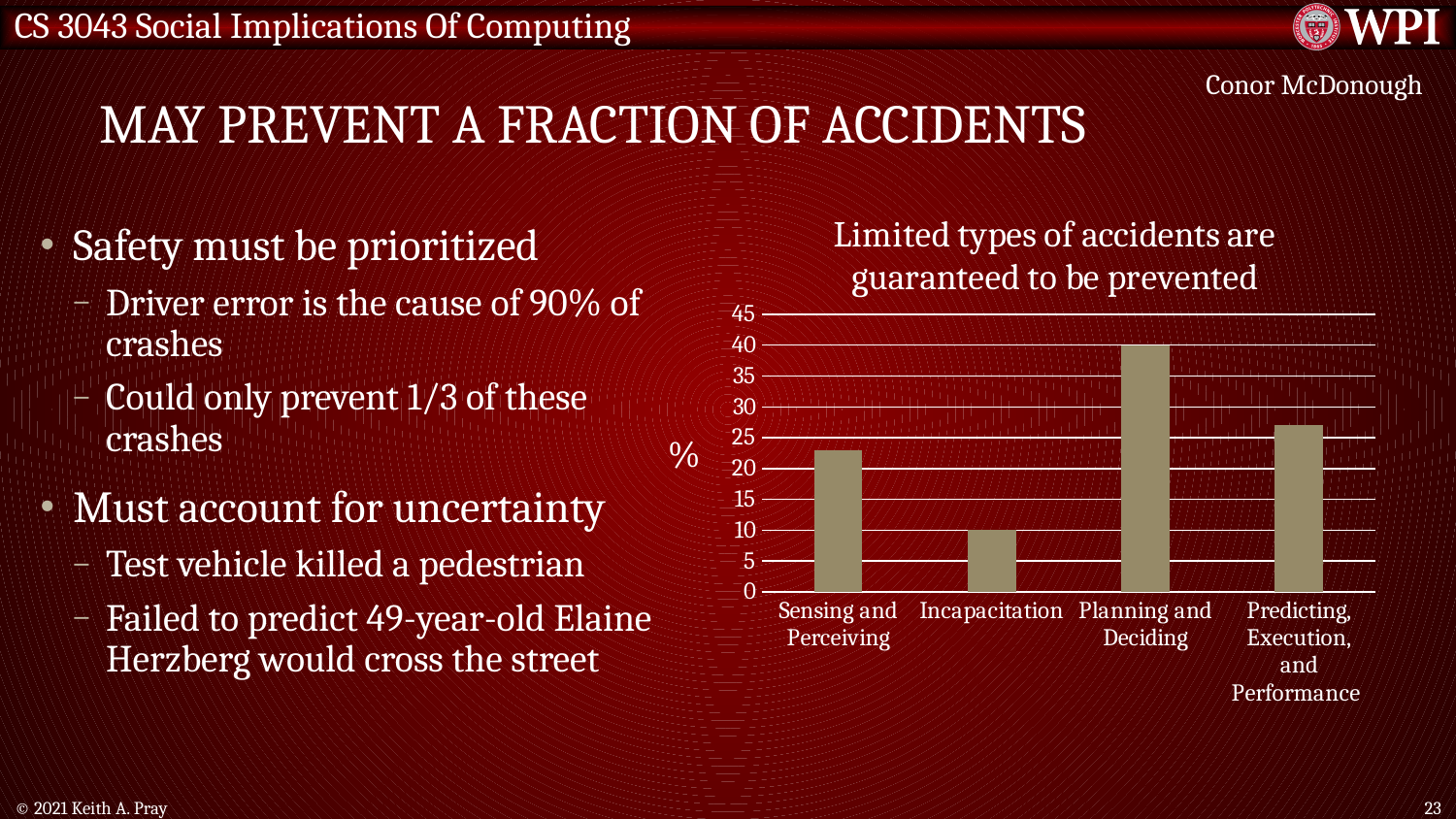
What is the value for Planning and Deciding? 40 Which category has the lowest value in the chart? Incapacitation What is the difference between the values for Planning and Deciding and Incapacitation? 30 What is the title of the chart? Limited types of accidents are guaranteed to be prevented Which category has the highest value in the chart? Planning and Deciding How many categories are shown on the x axis of the chart? 4 What is the value for Incapacitation? 10 Is the value for Predicting, Execution, and Performance greater or less than 30? less Which is larger, the value for Predicting, Execution, and Performance or the value for Sensing and Perceiving? Predicting, Execution, and Performance What is the label on the y axis of the chart? % Is the value for Sensing and Perceiving greater or less than 20? greater What type of chart is shown on the slide? bar chart